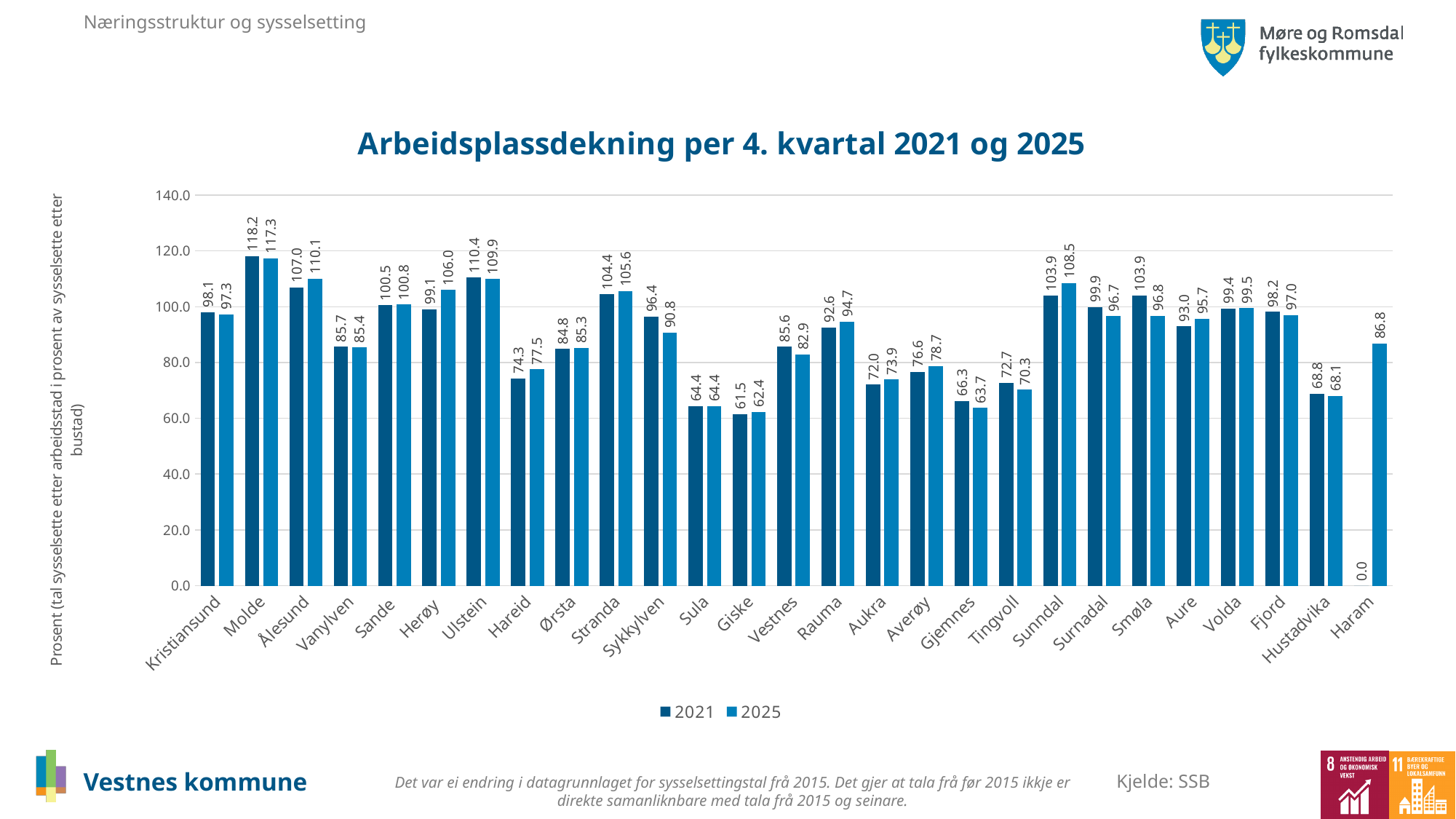
Is the 2025 value for Stranda greater or less than 100.0? greater What is the difference between the 2021 and 2025 values for Sykkylven? 5.6 What kind of chart is shown on the slide? Bar chart How many series does the legend list? 2 Which municipality has the highest 2021 value? Molde Which is larger for Ålesund, the 2021 value or the 2025 value? 2025 What is the difference between the 2021 and 2025 values for Herøy? 6.9 What is the 2021 value for Sunndal? 103.9 What is the 2025 value for Haram? 86.8 How many municipalities are shown on the x axis? 27 Which municipality has the lowest 2025 value? Giske What is the 2025 value for Vestnes? 82.9